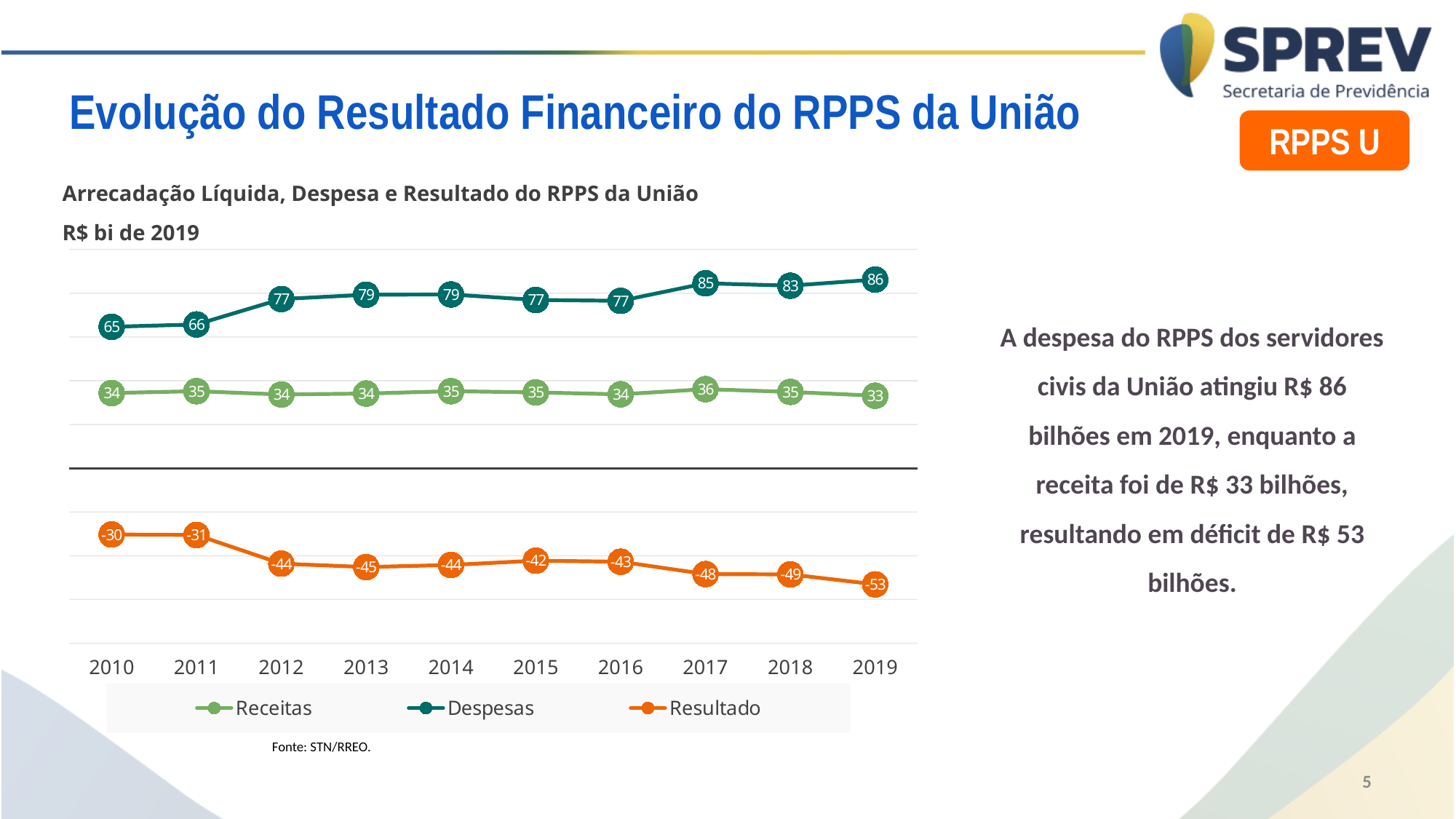
How many years are shown on the x axis? 10 In which year is Resultado lowest? 2019 Does Despesas rise or fall from 2010 to 2019? Rise What is the value of Receitas in 2010? 34 Which is larger in 2017, Despesas or Receitas? Despesas What is the difference between Despesas and Receitas in 2019? 53 In which year is Despesas lowest? 2010 What is the value of Despesas in 2019? 86 In which year is Despesas highest? 2019 How many series does the legend list? 3 What is the value of Resultado in 2015? -42 What kind of chart is shown? Line chart